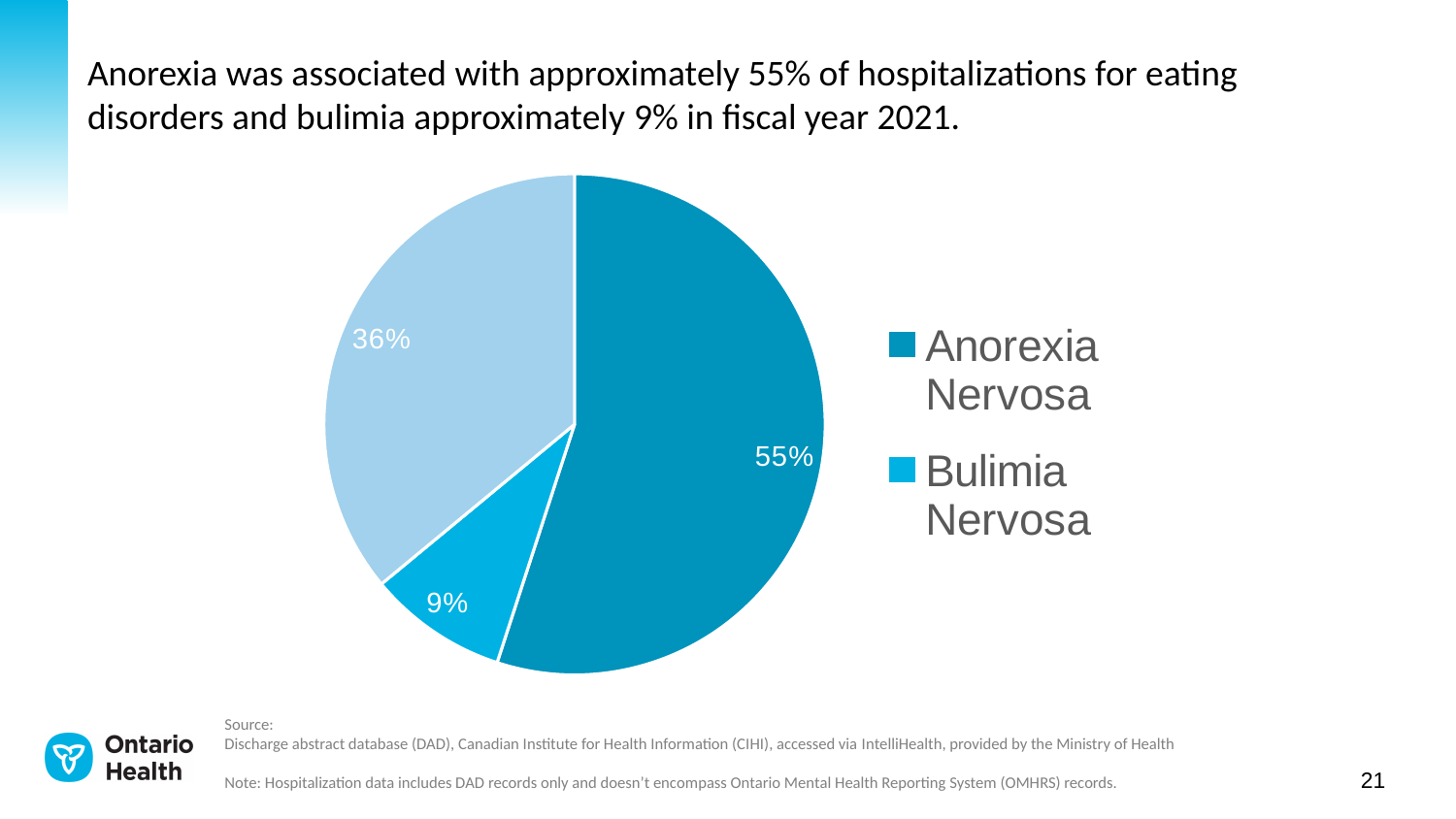
Which is larger, the Anorexia Nervosa slice or the Bulimia Nervosa slice? Anorexia Nervosa How many entries does the legend list? 2 Which category has the smallest slice of the pie? Bulimia Nervosa Which category has the largest slice of the pie? Anorexia Nervosa How many slices does the pie chart have? 3 What share of the pie does Anorexia Nervosa account for? 55% What colour is the Anorexia Nervosa slice in the pie chart? dark blue What share of the pie does Bulimia Nervosa account for? 9% What is the difference in percentage points between the Anorexia Nervosa slice and the Bulimia Nervosa slice? 46 What type of chart is shown on the slide? pie chart What percentage is shown on the light blue slice of the pie? 36% Is the Anorexia Nervosa share greater or less than 50%? greater